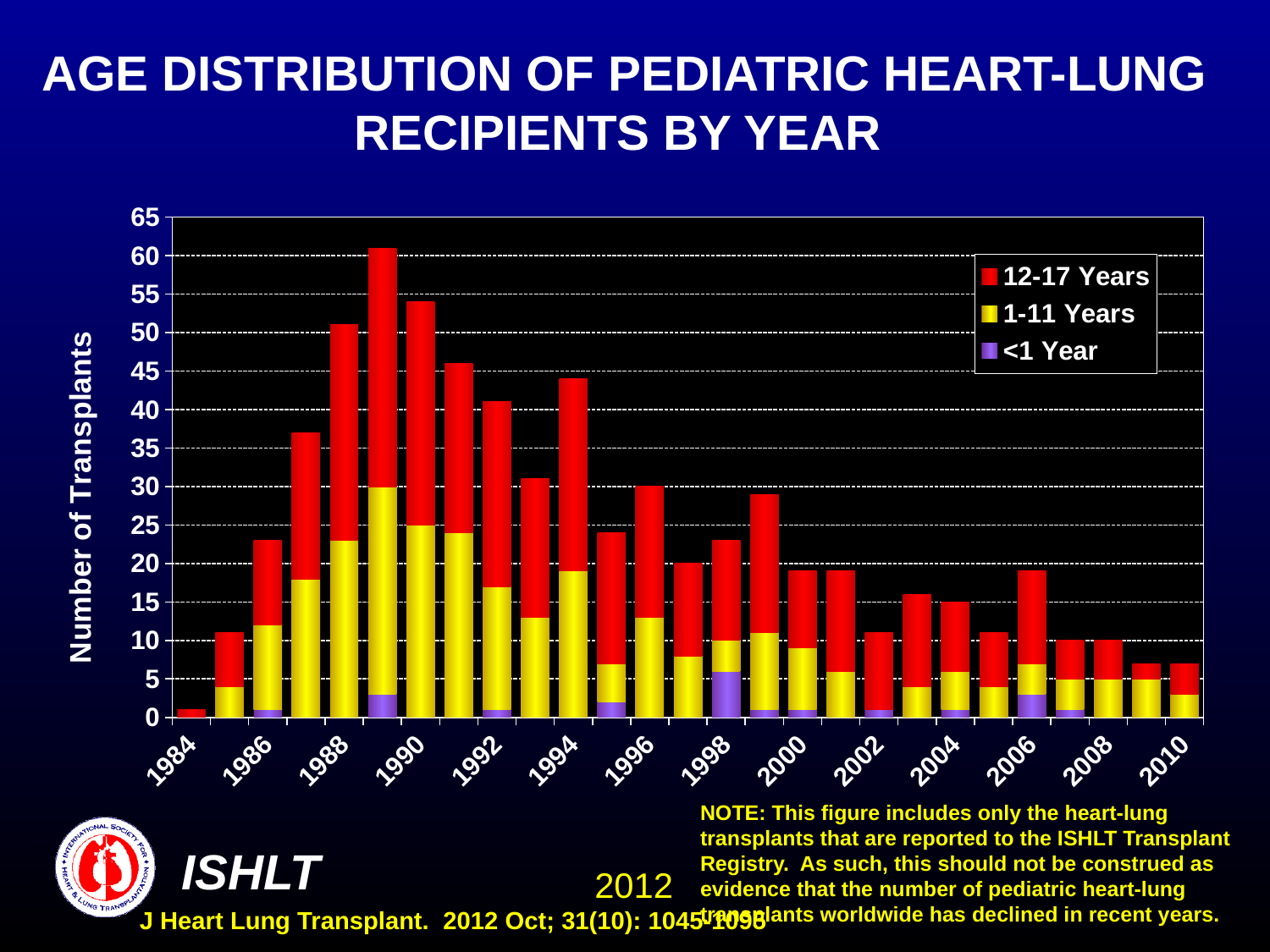
Is the total number of transplants in 1988 greater or less than 45? greater Which age group is listed first (at the top) in the legend? 12-17 Years Which year has the taller bar, 1986 or 2002? 1986 Do the total number of transplants generally rise or fall from 1990 to 2010? fall Is the total number of transplants in 1996 greater or less than 25? greater What is the title of the vertical axis? Number of Transplants Is the total number of transplants in 1984 greater or less than 5? less What kind of chart is shown on the slide? Stacked bar chart How many series does the legend list? 3 Which year has the taller bar, 2006 or 2008? 2006